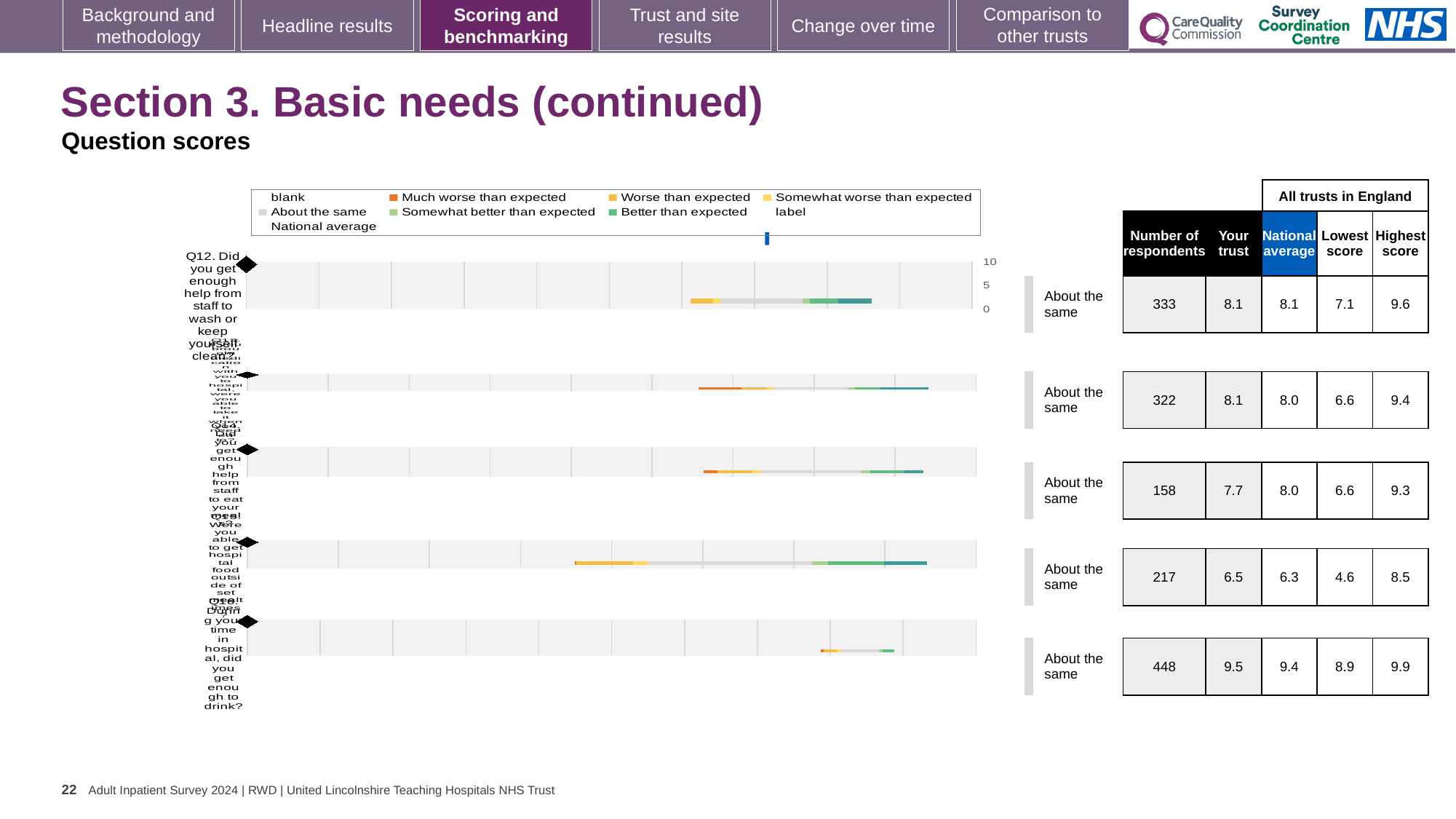
What kind of chart is used to show the question scores on this slide? bar chart What is the difference between the highest score (9.6) and the lowest score (7.1) for Q12? 2.5 In the chart legend, what colour represents 'Much worse than expected'? orange How many respondents are listed for Q12 (the first row of the chart)? 333 Which row of the chart has the lowest 'Your trust' score? the fourth row, 6.5 What is the 'Your trust' score for Q12 (the first row of the chart)? 8.1 For the fourth row of the chart, which is larger: the 'Your trust' score or the national average? Your trust How many question rows (bars) are plotted in the chart? 5 Which row of the chart has the highest 'Your trust' score? the fifth (bottom) row, 9.5 What is the national average score for Q12 (the first row of the chart)? 8.1